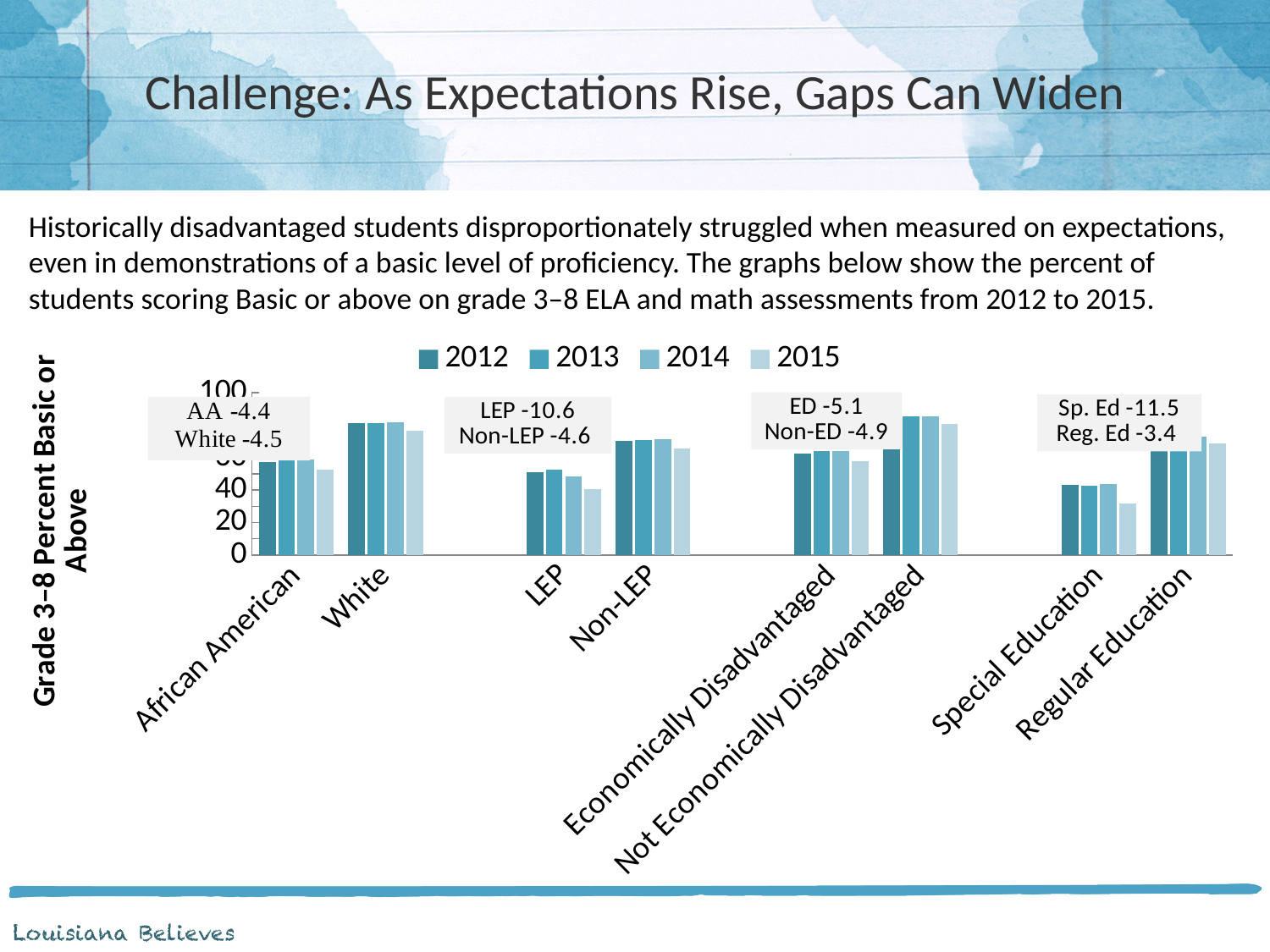
In 2013, which has the larger value, LEP or Non-LEP? Non-LEP How many student group categories are shown along the x axis of the chart? 8 How many series does the chart legend list? 4 Is the 2015 value for Regular Education greater or less than 60? greater Is the 2015 value for African American greater or less than 60? less Which category has the lowest 2015 value in the chart? Special Education Is the 2012 value for White greater or less than 60? greater What kind of chart is shown on the slide? bar chart What change is annotated on the chart for Sp. Ed? -11.5 Do the values for LEP rise or fall from 2012 to 2015? fall In 2012, which has the larger value, African American or White? White